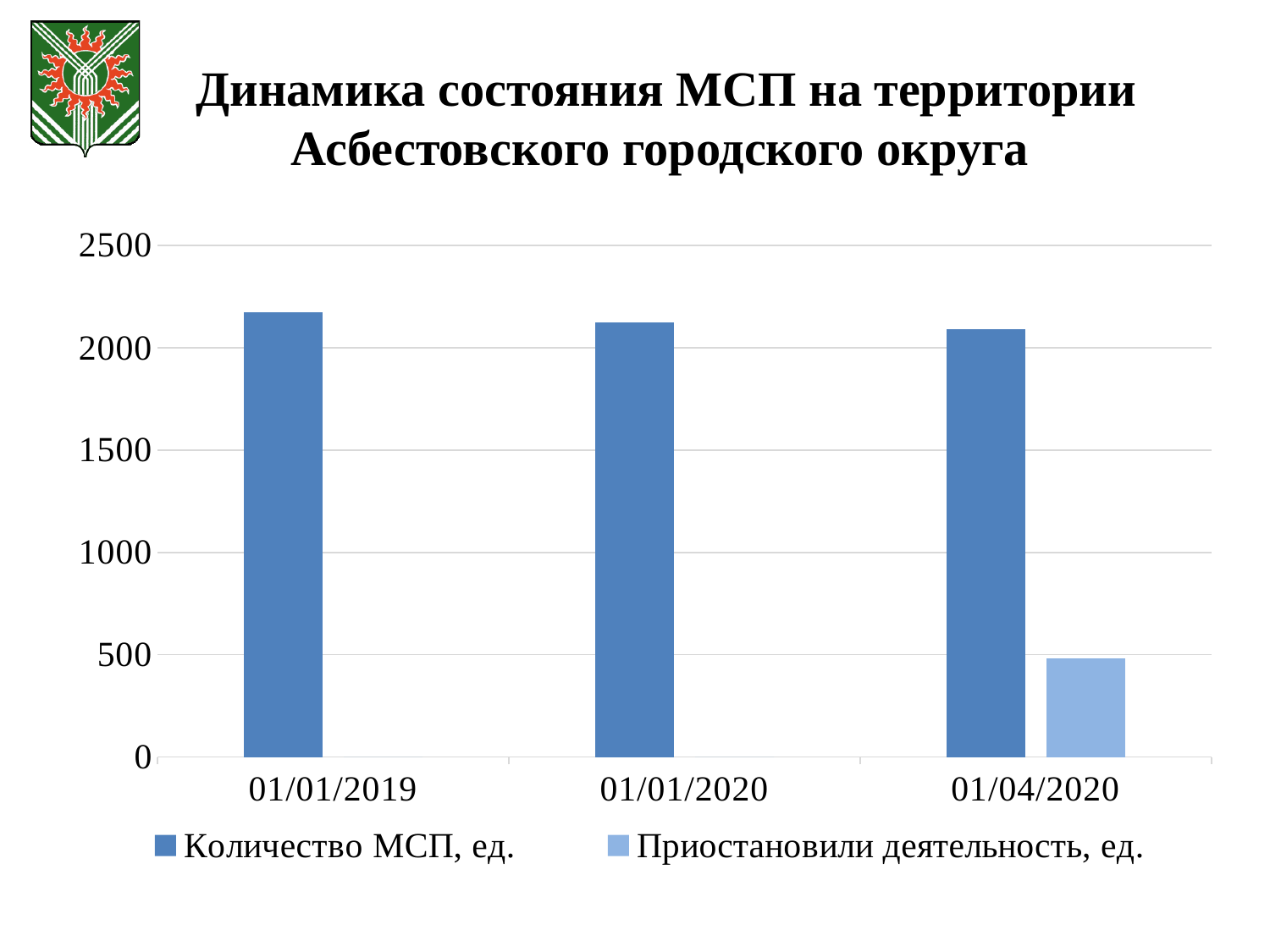
Is the value for Количество МСП, ед. on 01/04/2020 greater or less than 2000? greater What is the title of the chart? Динамика состояния МСП на территории Асбестовского городского округа How many series does the legend list? 2 Is the value for Количество МСП, ед. on 01/01/2019 greater or less than 2000? greater How many dates are shown on the x axis? 3 Is the value for Количество МСП, ед. on 01/01/2020 greater or less than 2500? less On which date is the value for Количество МСП, ед. the highest? 01/01/2019 Which is larger on 01/04/2020: Количество МСП, ед. or Приостановили деятельность, ед.? Количество МСП, ед. What kind of chart is shown on the slide? bar chart On which date does the series Приостановили деятельность, ед. appear in the chart? 01/04/2020 Does the value for Количество МСП, ед. rise or fall from 01/01/2019 to 01/04/2020? fall